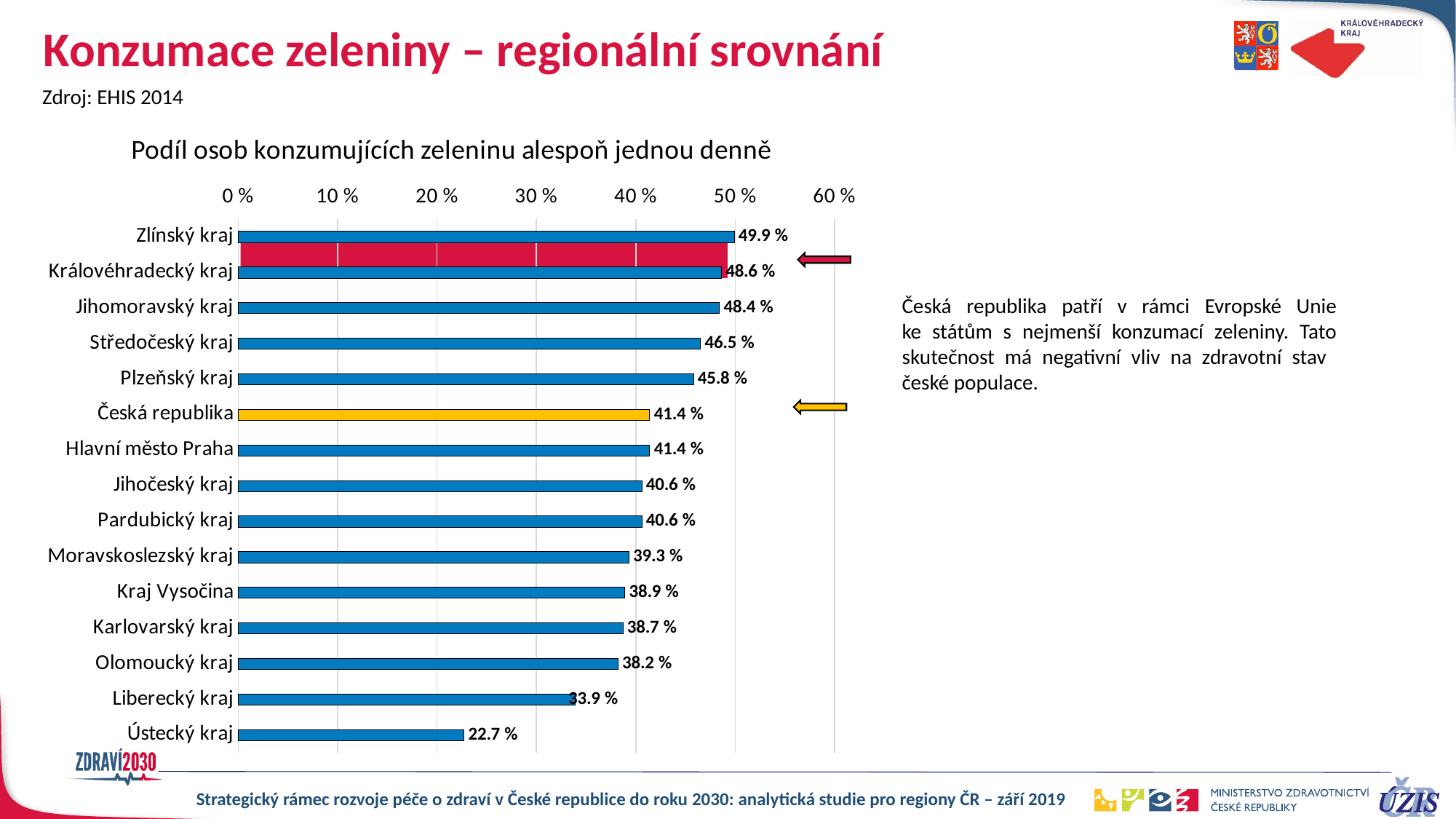
What is the difference between the values for Zlínský kraj and Ústecký kraj? 27.2 % What is the value for Královéhradecký kraj? 48.6 % Which category has the lowest value? Ústecký kraj How many categories are shown in the chart? 15 What is the value for Ústecký kraj? 22.7 % Which is larger, the value for Středočeský kraj or the value for Liberecký kraj? Středočeský kraj Which category has the highest value? Zlínský kraj What kind of chart is shown on the slide? bar chart Is the value for Plzeňský kraj greater or less than 40 %? greater What is the difference between the values for Královéhradecký kraj and Česká republika? 7.2 % What is the value for Česká republika? 41.4 % What is the value for Moravskoslezský kraj? 39.3 %